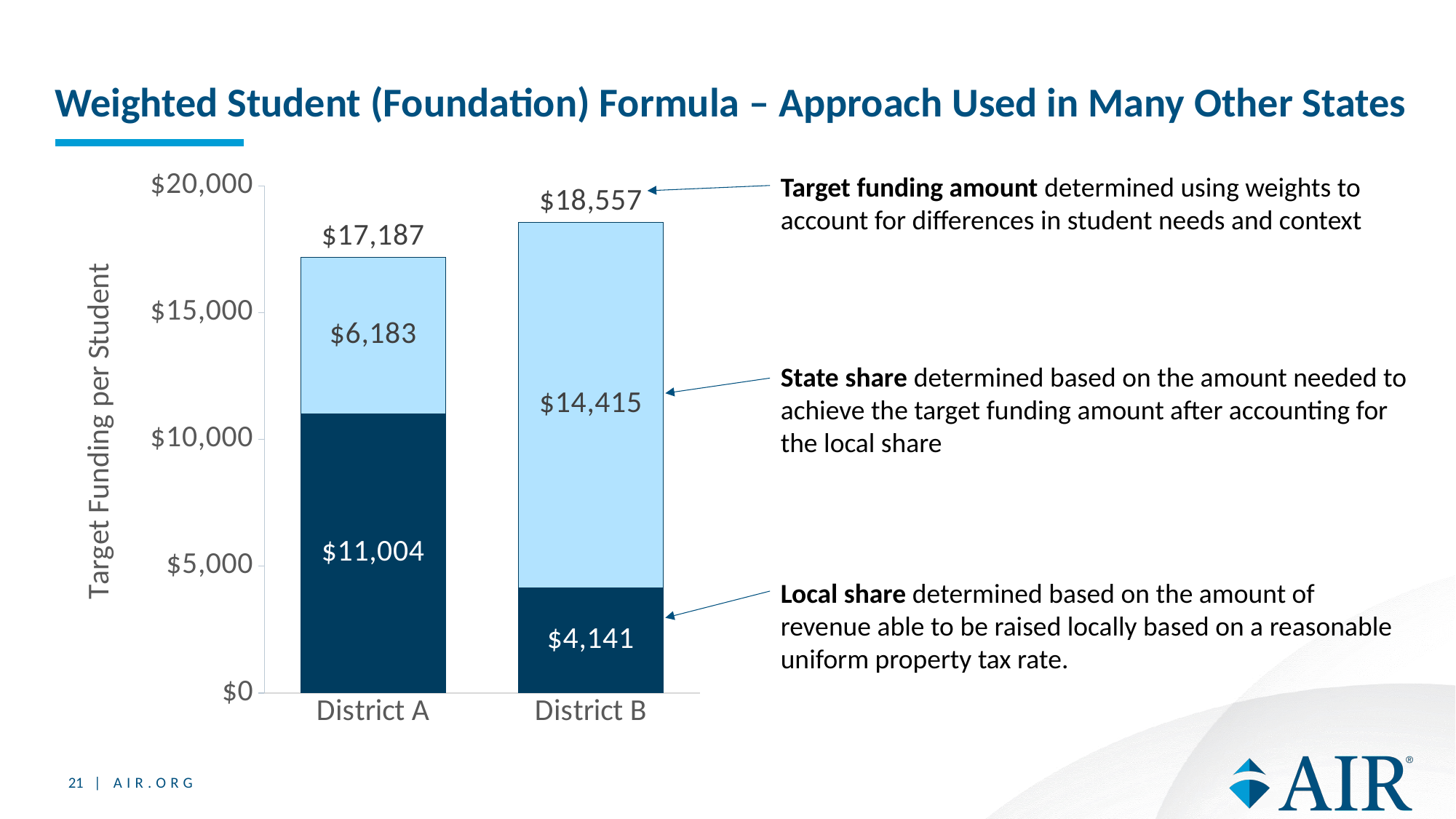
Which district has the lower local share? District B What is the difference between the total target funding for District B and District A? $1,370 Which district has the higher total target funding per student? District B How many districts are shown on the x axis? 2 Is the local share for District A larger or smaller than the local share for District B? larger What kind of chart is shown on the slide? Stacked bar chart What is the total target funding per student for District B? $18,557 What is the local share for District B? $4,141 What is the local share for District A? $11,004 What is the total target funding per student for District A? $17,187 What is the state share for District A? $6,183 What is the state share for District B? $14,415